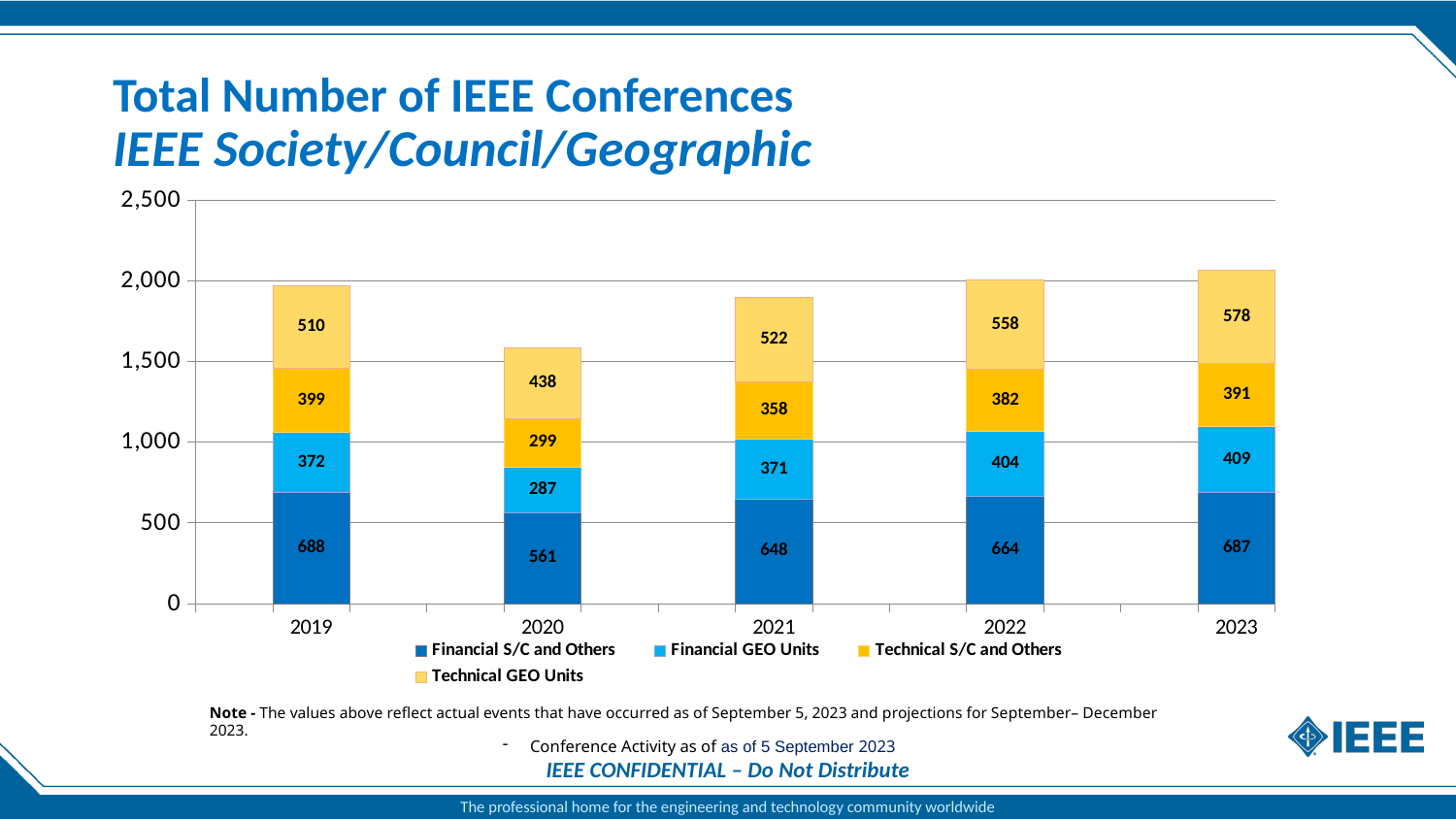
What is the value for Technical GEO Units in 2023? 578 What is the total of the stacked bar for 2020? 1,585 Which year has the lowest value for Technical S/C and Others? 2020 What is the total of the stacked bar for 2023? 2,065 What kind of chart is shown on the slide? Stacked bar chart How many years are shown on the x axis? 5 Which is larger: Financial S/C and Others in 2021 or in 2022? 2022 How many series does the legend list? 4 What is the difference between the Technical GEO Units values for 2022 and 2021? 36 What is the value for Financial S/C and Others in 2019? 688 Which year has the highest value for Financial GEO Units? 2023 What is the value for Financial GEO Units in 2020? 287